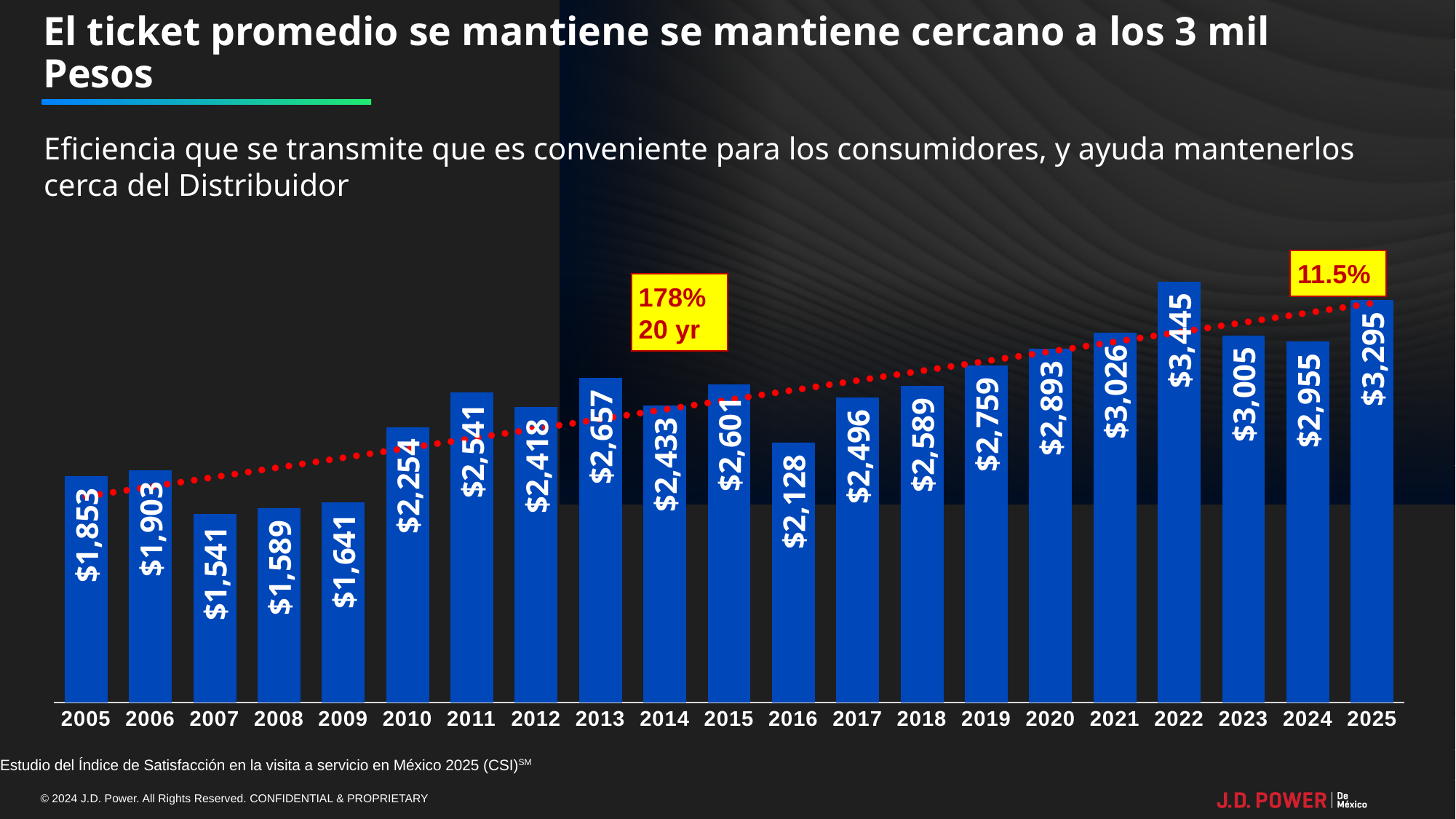
What is the value for 2025? $3,295 What is the difference between the values for 2025 and 2024? $340 What kind of chart is this? bar chart Which year has the lowest value? 2007 What is the value for 2016? $2,128 How many years are shown on the x axis? 21 What is the value for 2005? $1,853 What percentage is shown in the yellow box above the 2025 bar? 11.5% Which year has the highest value? 2022 Which is larger, the value for 2013 or the value for 2014? 2013 What growth over 20 years is shown in the yellow box in the middle of the chart? 178% Do the values generally rise or fall from 2005 to 2025? rise